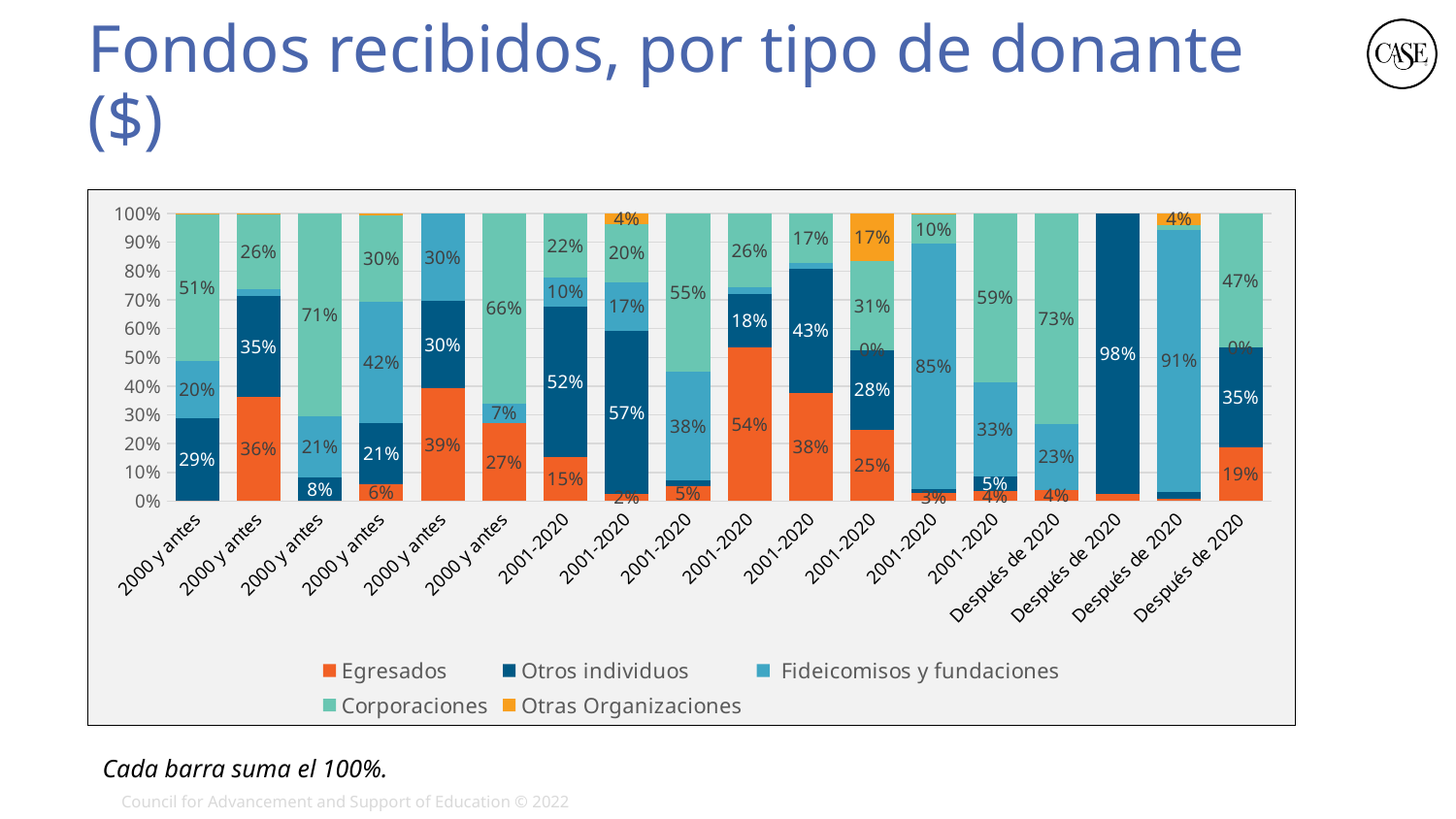
In the rightmost bar (Después de 2020), what is the value for Corporaciones? 47% Which series has the largest share in the leftmost bar? Corporaciones In the leftmost bar (2000 y antes), what is the value for Egresados? 0% In the leftmost bar, which is larger: the Egresados share or the Fideicomisos y fundaciones share? Fideicomisos y fundaciones How many series does the legend list? 5 How many bars are plotted in the chart? 18 In the leftmost bar (2000 y antes), what is the value for Corporaciones? 51% In the rightmost bar (Después de 2020), what is the value for Egresados? 19% What kind of chart is shown on the slide? Stacked bar chart What is the title of the chart slide? Fondos recibidos, por tipo de donante ($) In the rightmost bar (Después de 2020), what is the value for Otros individuos? 35% In the leftmost bar, what is the difference between the Corporaciones share and the Egresados share? 51 percentage points